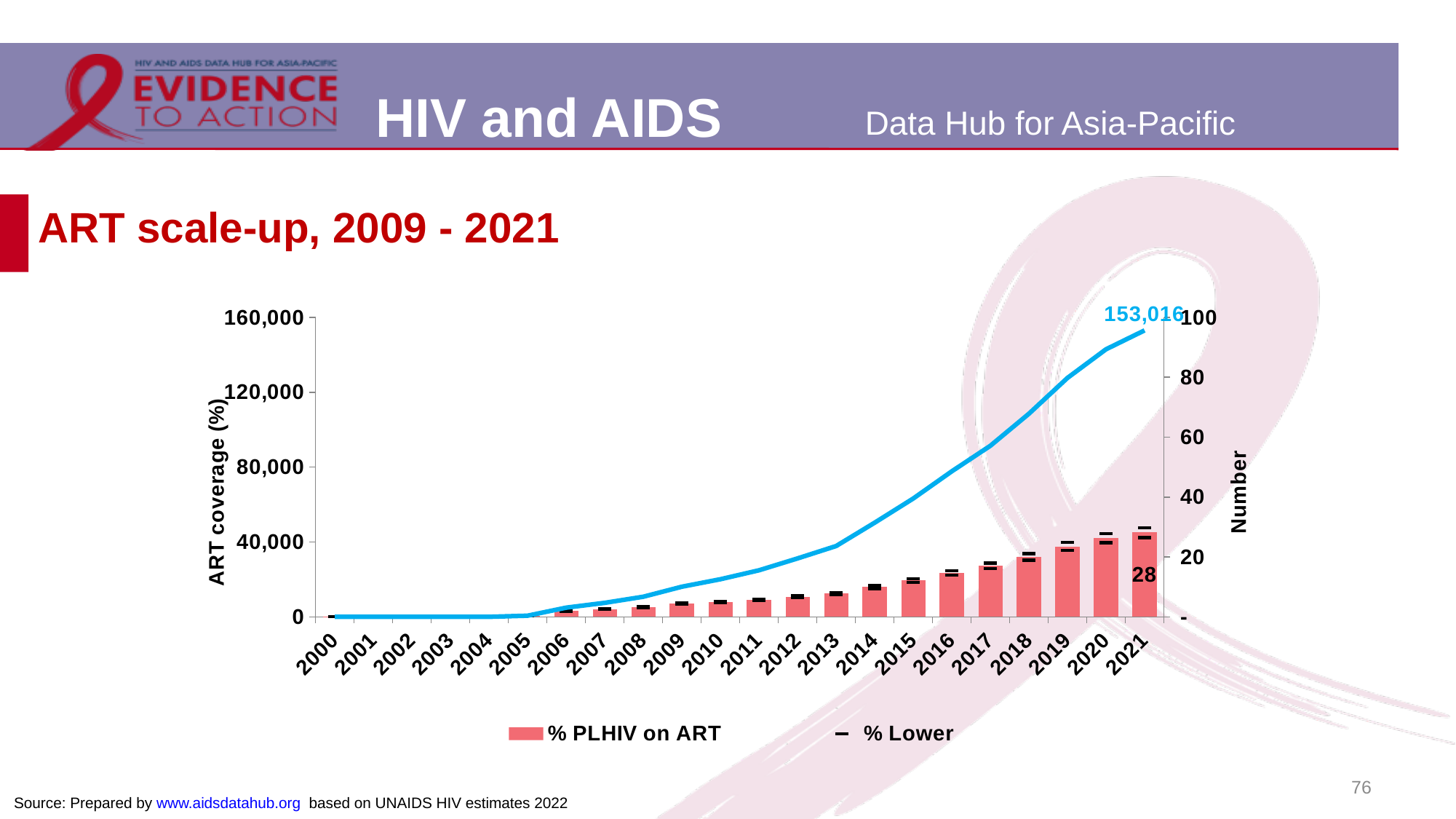
Do the % PLHIV on ART bars rise or fall from 2006 to 2021? Rise What is the data label shown on the line for 2021? 153,016 How many entries does the legend list? 2 What kind of chart is this? Combined bar and line chart What is the title of the chart? ART scale-up, 2009 - 2021 Which year has the tallest bar for % PLHIV on ART? 2021 Which year has a taller % PLHIV on ART bar, 2010 or 2021? 2021 What is the title of the right-hand vertical axis? Number Is the % PLHIV on ART bar for 2015 greater or less than 20 on the right axis? less Is the line value for 2013 greater or less than 80,000 on the left axis? less What is the value of % PLHIV on ART for 2021? 28 How many years are shown on the x axis? 22